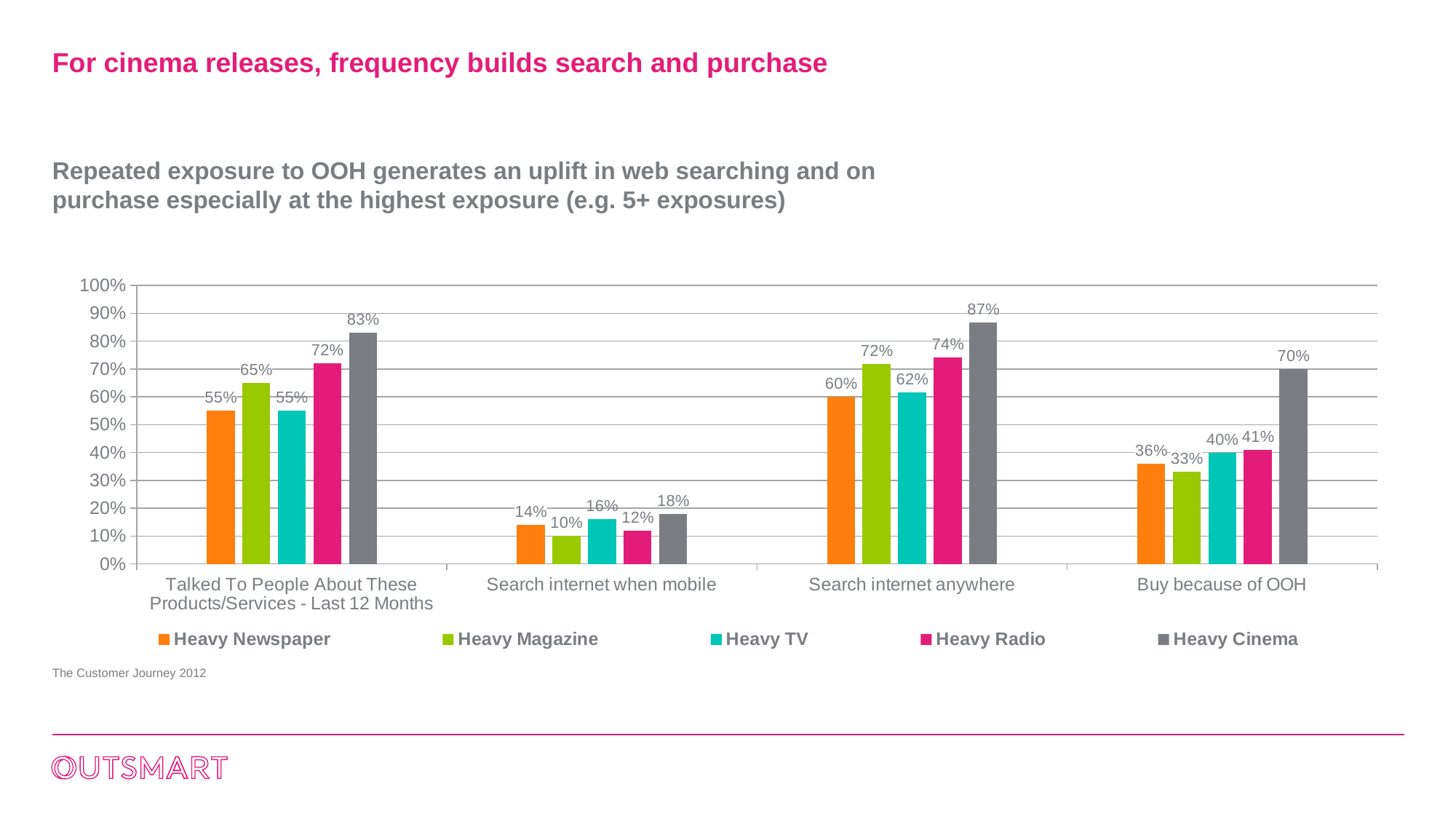
In the 'Search internet anywhere' category, which is larger: Heavy Magazine or Heavy TV? Heavy Magazine Which series has the highest value in the 'Buy because of OOH' category? Heavy Cinema How many series does the legend list? 5 What kind of chart is shown on the slide? Bar chart What is the value for Heavy Radio in the 'Search internet when mobile' category? 12% What is the value for Heavy Magazine in the 'Talked To People About These Products/Services - Last 12 Months' category? 65% How many categories are shown on the x axis? 4 What is the value for Heavy Cinema in the 'Search internet anywhere' category? 87% Which series has the lowest value in the 'Search internet when mobile' category? Heavy Magazine What is the difference between Heavy Cinema and Heavy Newspaper in the 'Buy because of OOH' category? 34% Which colour represents Heavy Cinema in the legend? Grey What is the difference between Heavy Cinema and Heavy Newspaper in the 'Talked To People About These Products/Services - Last 12 Months' category? 28%